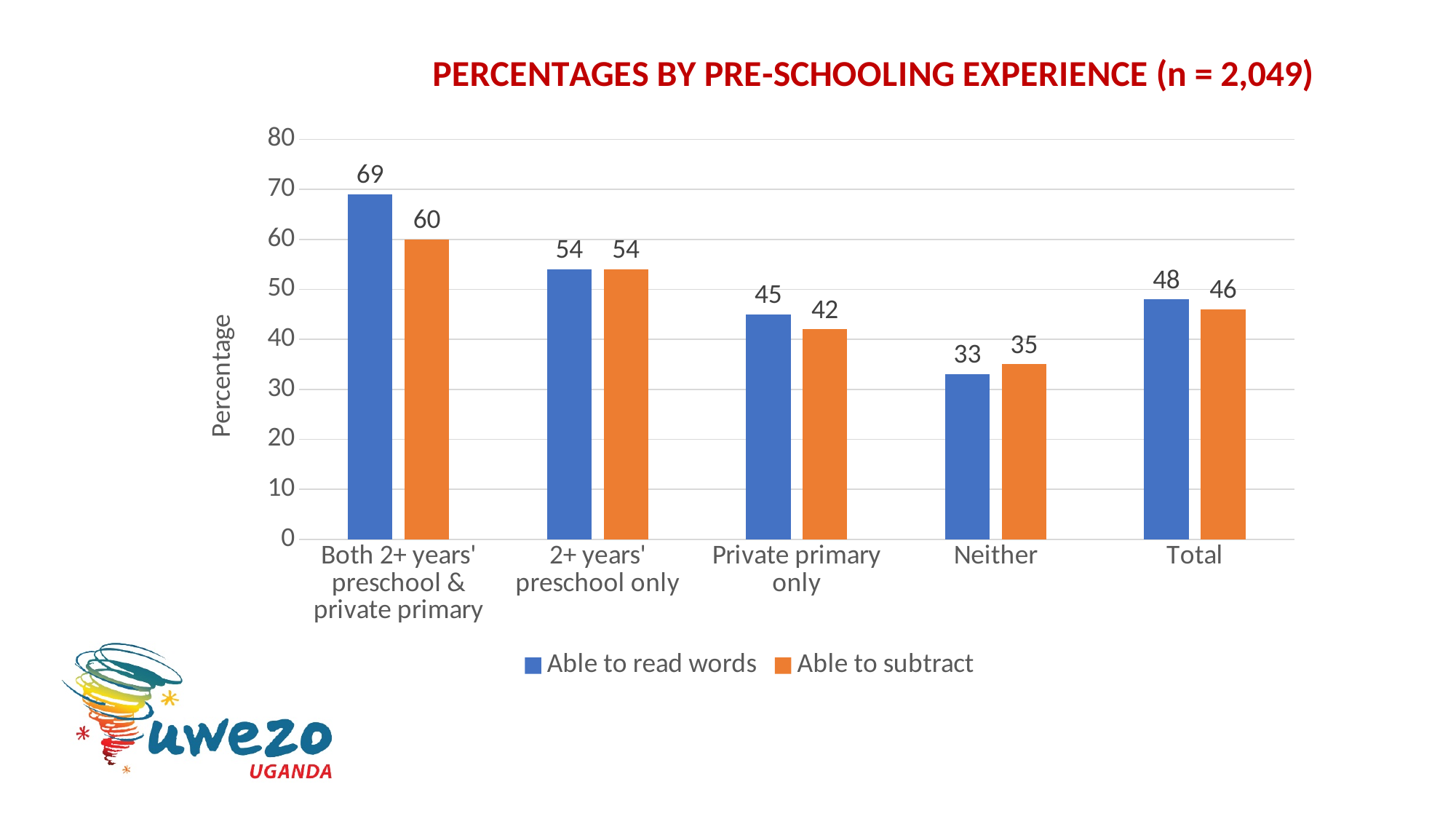
How many series does the legend list? 2 What kind of chart is shown on the slide? Bar chart What is the title of the chart? PERCENTAGES BY PRE-SCHOOLING EXPERIENCE (n = 2,049) What is the value for 'Able to subtract' in the 'Both 2+ years' preschool & private primary' category? 60 In the 'Neither' category, which is larger: 'Able to read words' or 'Able to subtract'? Able to subtract Is the value for 'Able to read words' in the 'Private primary only' category greater or less than 40? greater What is the difference between 'Able to read words' and 'Able to subtract' in the 'Both 2+ years' preschool & private primary' category? 9 Which category has the highest value for 'Able to read words'? Both 2+ years' preschool & private primary What is the value for 'Able to read words' in the 'Neither' category? 33 Which category has the lowest value for 'Able to subtract'? Neither What is the value for 'Able to subtract' in the 'Total' category? 46 How many categories are shown on the x axis? 5